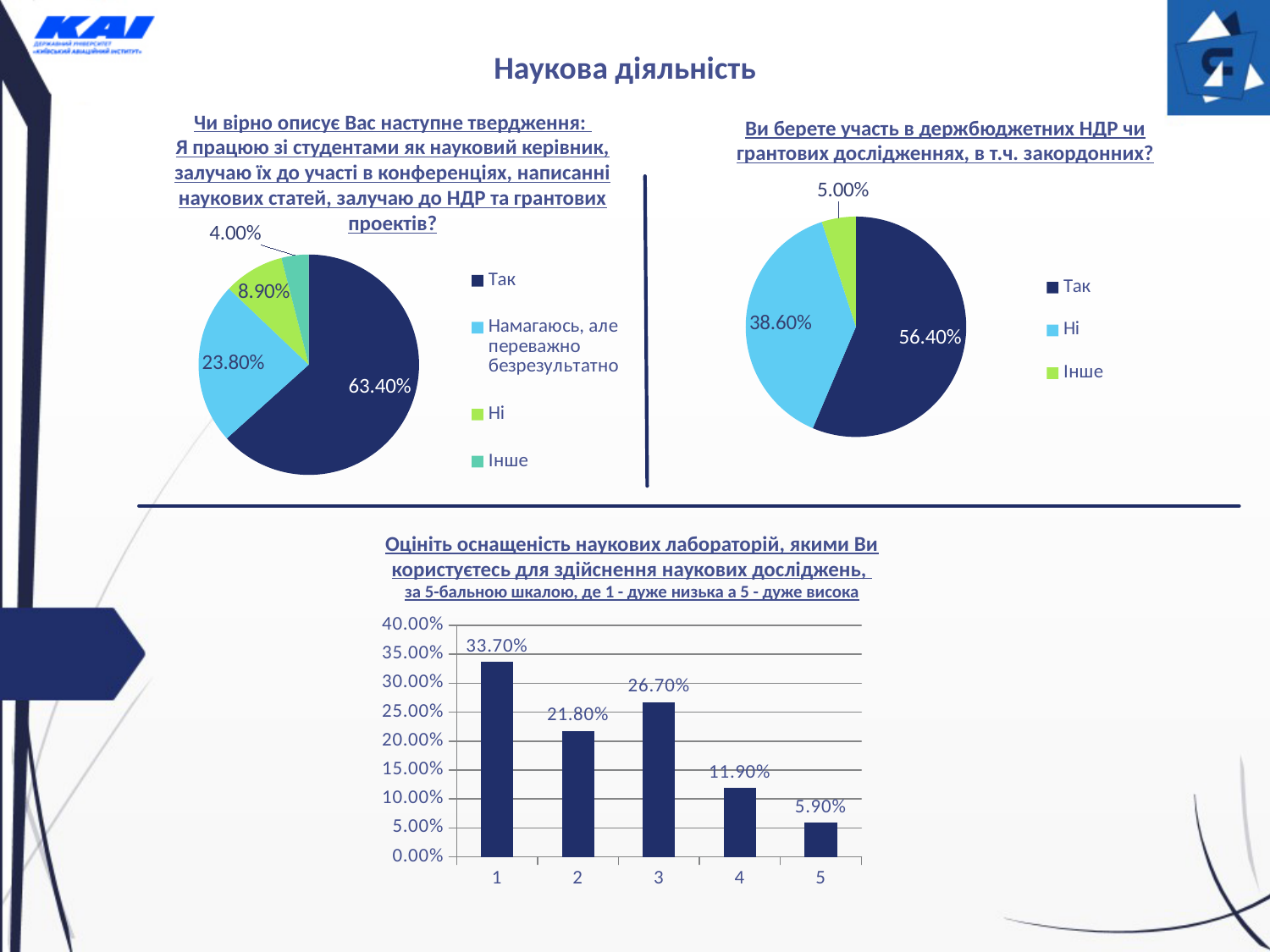
In the top-left pie chart, what share of respondents answered "Ні"? 8.90% In the bottom bar chart, is the value for rating 4 greater or less than 15.00%? less In the top-right pie chart, which category has the largest slice? Так In the top-right pie chart, what share of respondents answered "Ні"? 38.60% In the top-right pie chart, what is the difference between the "Так" and "Ні" shares? 17.80% In the bottom bar chart, what is the value for rating 3? 26.70% In the bottom bar chart, what is the difference between the values for rating 1 and rating 2? 11.90% In the top-left pie chart, what share of respondents answered "Так"? 63.40% What type of chart is shown at the bottom of the slide? Bar chart In the top-left pie chart, which category has the smallest slice? Інше In the bottom bar chart, which rating has the lowest value? 5 How many legend entries does the top-left pie chart have? 4